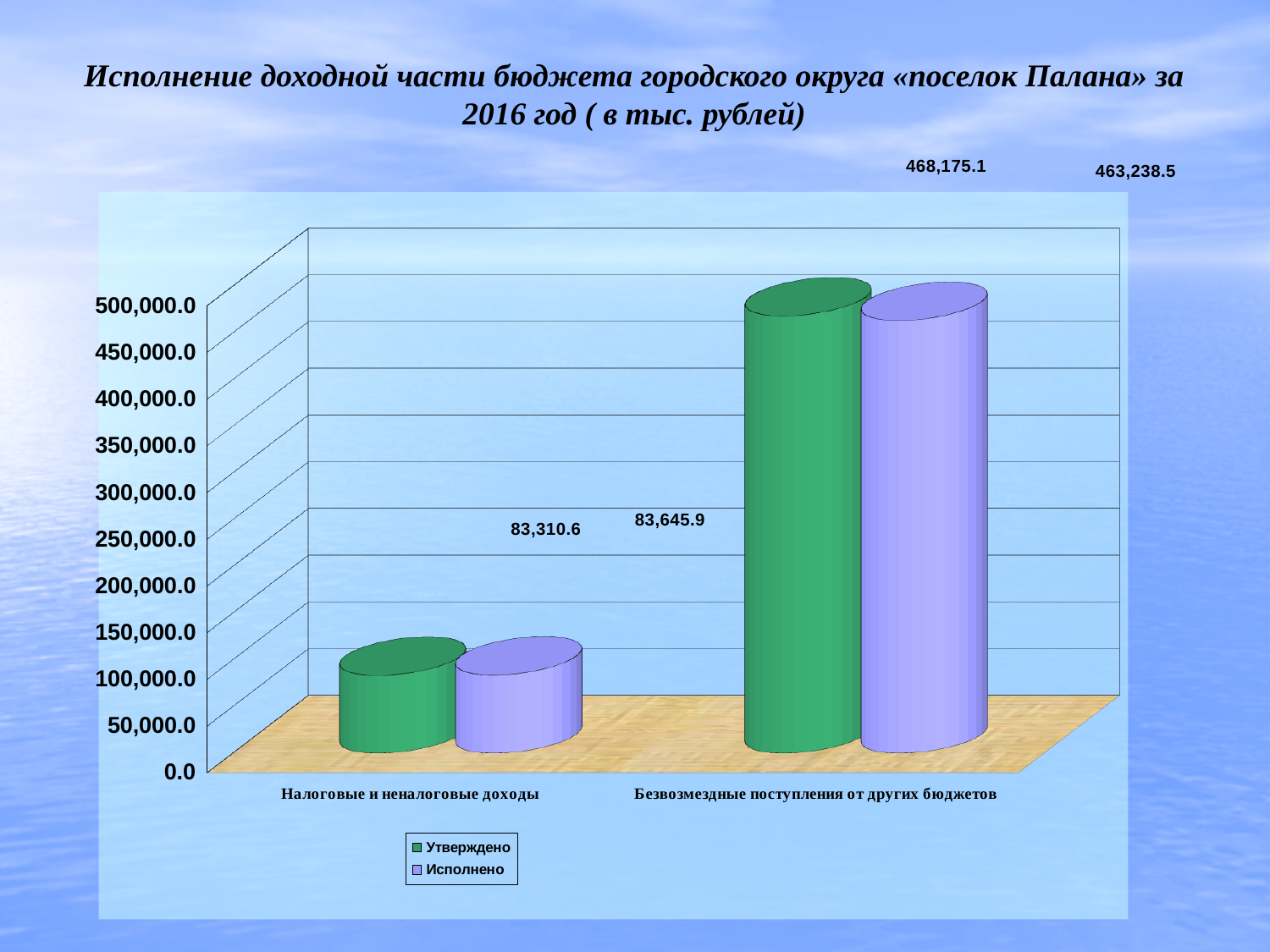
What is the difference between the Исполнено and Утверждено values for Налоговые и неналоговые доходы? 335.3 What is the Исполнено value for Налоговые и неналоговые доходы? 83,645.9 Which is larger: the Исполнено value for Безвозмездные поступления от других бюджетов or the Исполнено value for Налоговые и неналоговые доходы? Безвозмездные поступления от других бюджетов Which category has the lowest Исполнено value? Налоговые и неналоговые доходы What is the Исполнено value for Безвозмездные поступления от других бюджетов? 463,238.5 What is the Утверждено value for Налоговые и неналоговые доходы? 83,310.6 How many series does the legend list? 2 What is the Утверждено value for Безвозмездные поступления от других бюджетов? 468,175.1 Which category has the highest Утверждено value? Безвозмездные поступления от других бюджетов What kind of chart is shown on the slide? bar chart Is the Утверждено value for Безвозмездные поступления от других бюджетов greater or less than 400,000.0? greater What is the difference between the Утверждено and Исполнено values for Безвозмездные поступления от других бюджетов? 4,936.6